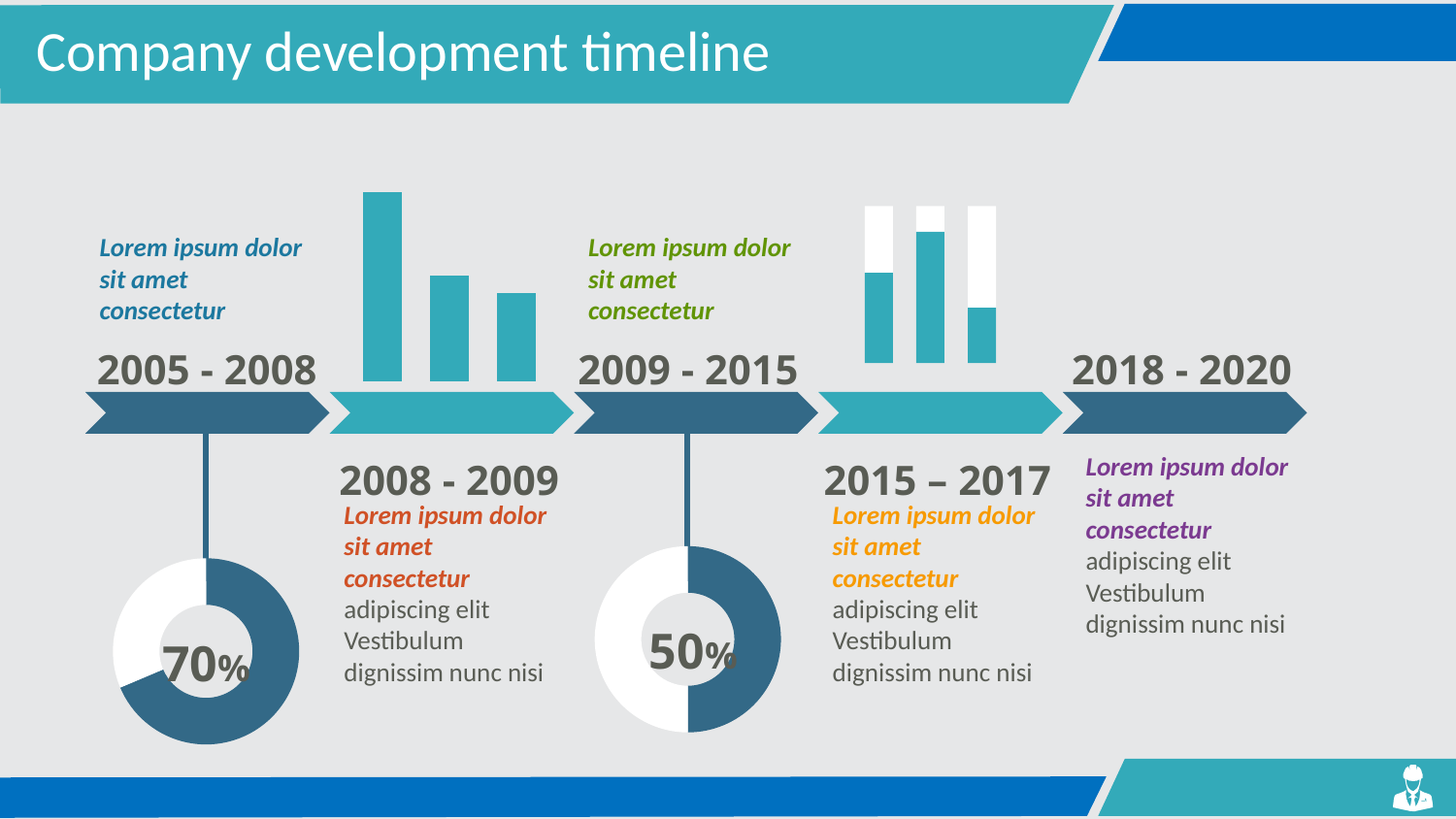
What kind of chart is shown above the 2005 - 2008 to 2009 - 2015 section of the timeline? Bar chart In the bar chart above the 2008 - 2009 segment, do the bars rise or fall from left to right? Fall What is the title of the slide containing these charts? Company development timeline In the bar chart above the 2015 – 2017 segment, which bar is the tallest: left, middle or right? Middle In the bar chart above the 2008 - 2009 segment, which bar is the tallest: left, middle or right? Left What percentage is shown in the donut chart in the middle of the slide? 50% How many bars are in the bar chart above the 2008 - 2009 segment of the timeline? 3 How many bars are in the bar chart above the 2015 – 2017 segment of the timeline? 3 What is the difference between the percentages shown in the left donut chart and the middle donut chart? 20 percentage points What percentage is shown in the donut chart on the left of the slide? 70% Which donut chart shows the larger percentage, the left one or the middle one? The left one (70%) What kind of chart is used to display the 70% and 50% values? Donut (pie) chart